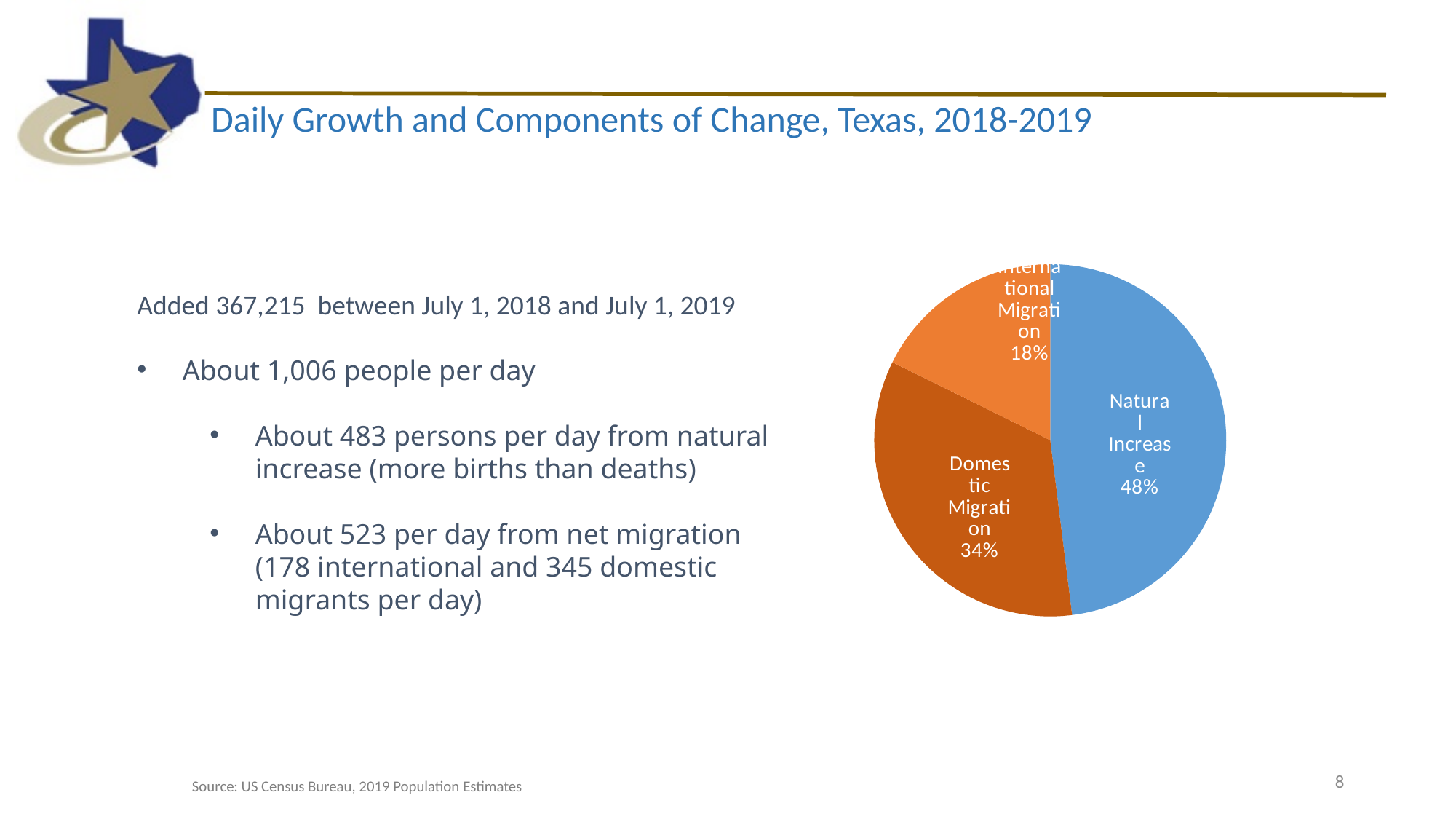
What share of the pie does Domestic Migration represent? 34% What kind of chart is shown on the slide? pie chart What is the difference in percentage points between Domestic Migration and International Migration? 16 What share of the pie does Natural Increase represent? 48% What is the difference in percentage points between Natural Increase and Domestic Migration? 14 Which slice of the pie chart is the smallest? International Migration What is the combined share of Domestic Migration and International Migration? 52% What share of the pie does International Migration represent? 18% Which is larger, the Domestic Migration slice or the International Migration slice? Domestic Migration Which slice of the pie chart is the largest? Natural Increase How many slices does the pie chart have? 3 What colour is the Natural Increase slice? blue